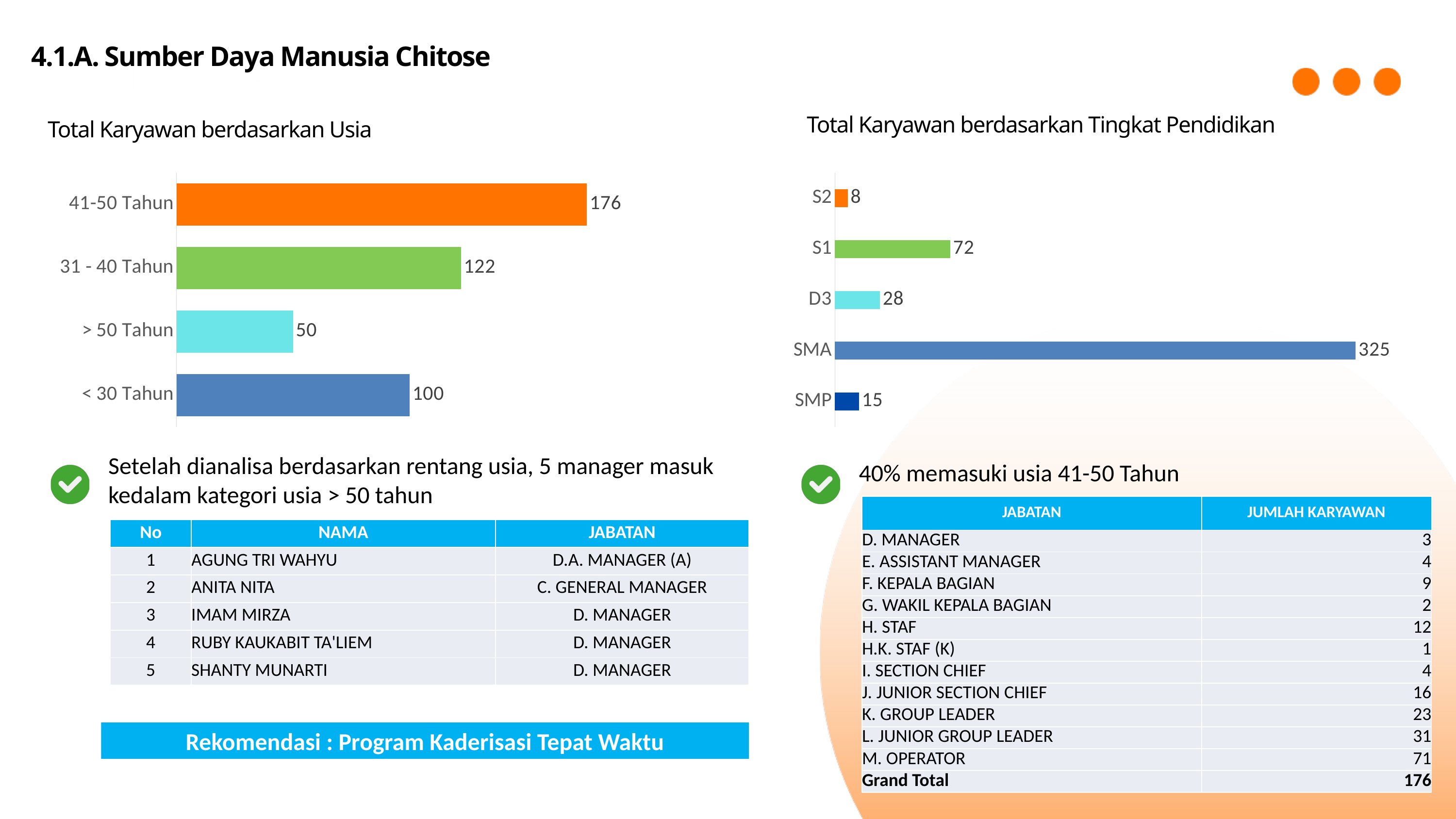
In the 'Total Karyawan berdasarkan Usia' chart, what is the value for > 50 Tahun? 50 In the 'Total Karyawan berdasarkan Usia' chart, what is the difference between 41-50 Tahun and 31 - 40 Tahun? 54 In the 'Total Karyawan berdasarkan Tingkat Pendidikan' chart, what is the difference between S1 and SMP? 57 In the 'Total Karyawan berdasarkan Usia' chart, which age category has the lowest value? > 50 Tahun In the 'Total Karyawan berdasarkan Tingkat Pendidikan' chart, which education level has the highest value? SMA What type of chart is 'Total Karyawan berdasarkan Tingkat Pendidikan'? Bar chart In the 'Total Karyawan berdasarkan Usia' chart, what is the value for 41-50 Tahun? 176 In the 'Total Karyawan berdasarkan Tingkat Pendidikan' chart, what is the value for SMA? 325 In the 'Total Karyawan berdasarkan Tingkat Pendidikan' chart, which education level has the lowest value? S2 In the 'Total Karyawan berdasarkan Tingkat Pendidikan' chart, what is the value for D3? 28 In the 'Total Karyawan berdasarkan Usia' chart, which is larger, < 30 Tahun or > 50 Tahun? < 30 Tahun In the 'Total Karyawan berdasarkan Usia' chart, how many age categories are shown? 4